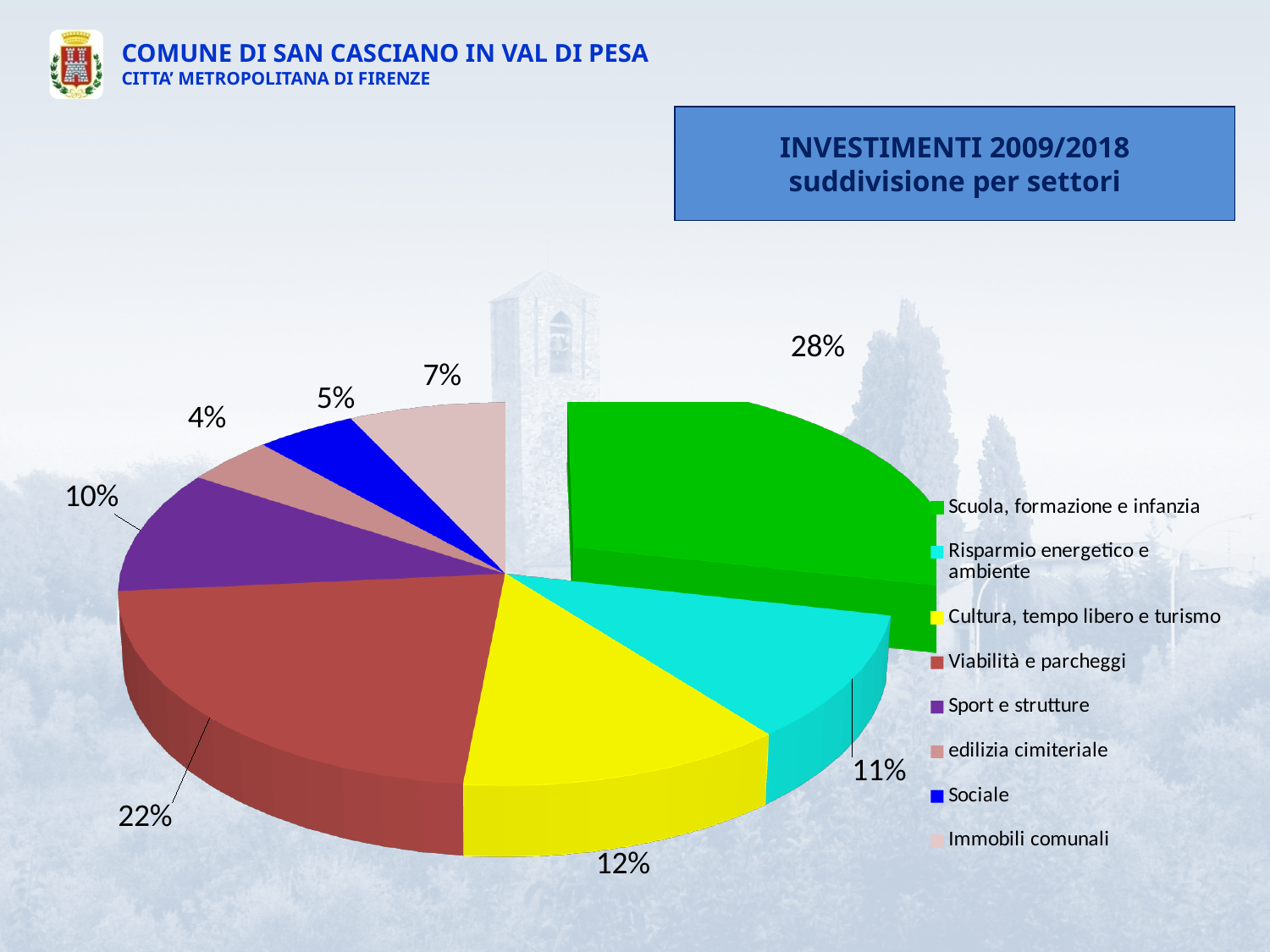
What share of investments goes to Cultura, tempo libero e turismo? 12% What share of investments goes to Risparmio energetico e ambiente? 11% Which has a larger share, Sport e strutture or Immobili comunali? Sport e strutture What is the difference in percentage points between Scuola, formazione e infanzia and Viabilità e parcheggi? 6 percentage points What share of investments goes to Scuola, formazione e infanzia? 28% What is the title of the chart? INVESTIMENTI 2009/2018 suddivisione per settori Which sector has the largest share of investments? Scuola, formazione e infanzia What kind of chart is shown on the slide? Pie chart Which sector has the smallest share of investments? edilizia cimiteriale How many sectors does the legend list? 8